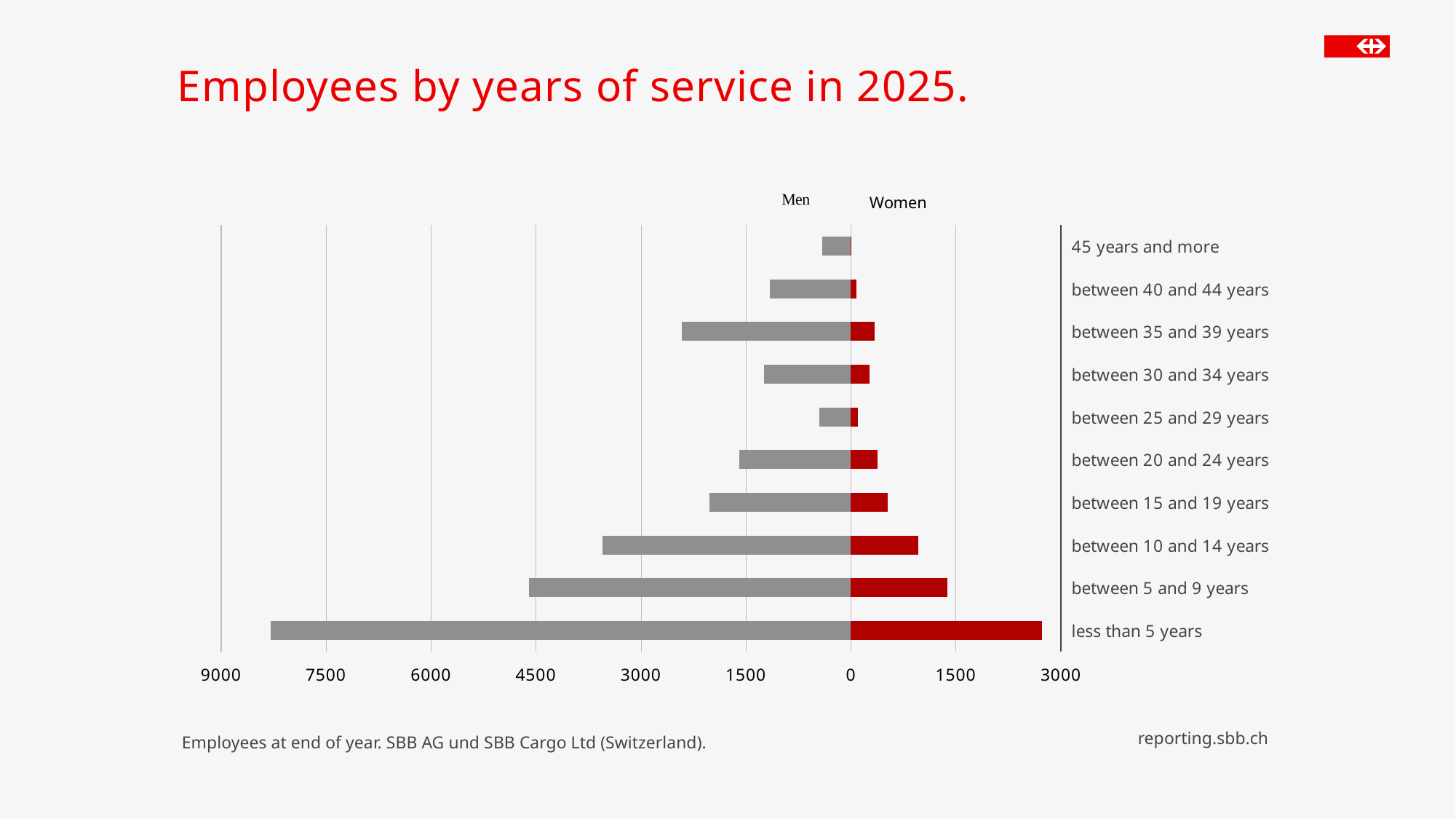
Is the number of men with between 25 and 29 years of service greater or less than 1500? less How many years-of-service categories are shown in the chart? 10 Which years-of-service category has the highest number of men? less than 5 years How many series does the chart show? 2 What colour are the bars for women in the chart? red What kind of chart is shown on the slide? bar chart Is the number of men with between 10 and 14 years of service greater or less than 3000? greater Which years-of-service category has the lowest number of women? 45 years and more Which years-of-service category has the highest number of women? less than 5 years Is the number of men with less than 5 years of service greater or less than 7500? greater Which has more men: between 35 and 39 years or between 30 and 34 years of service? between 35 and 39 years